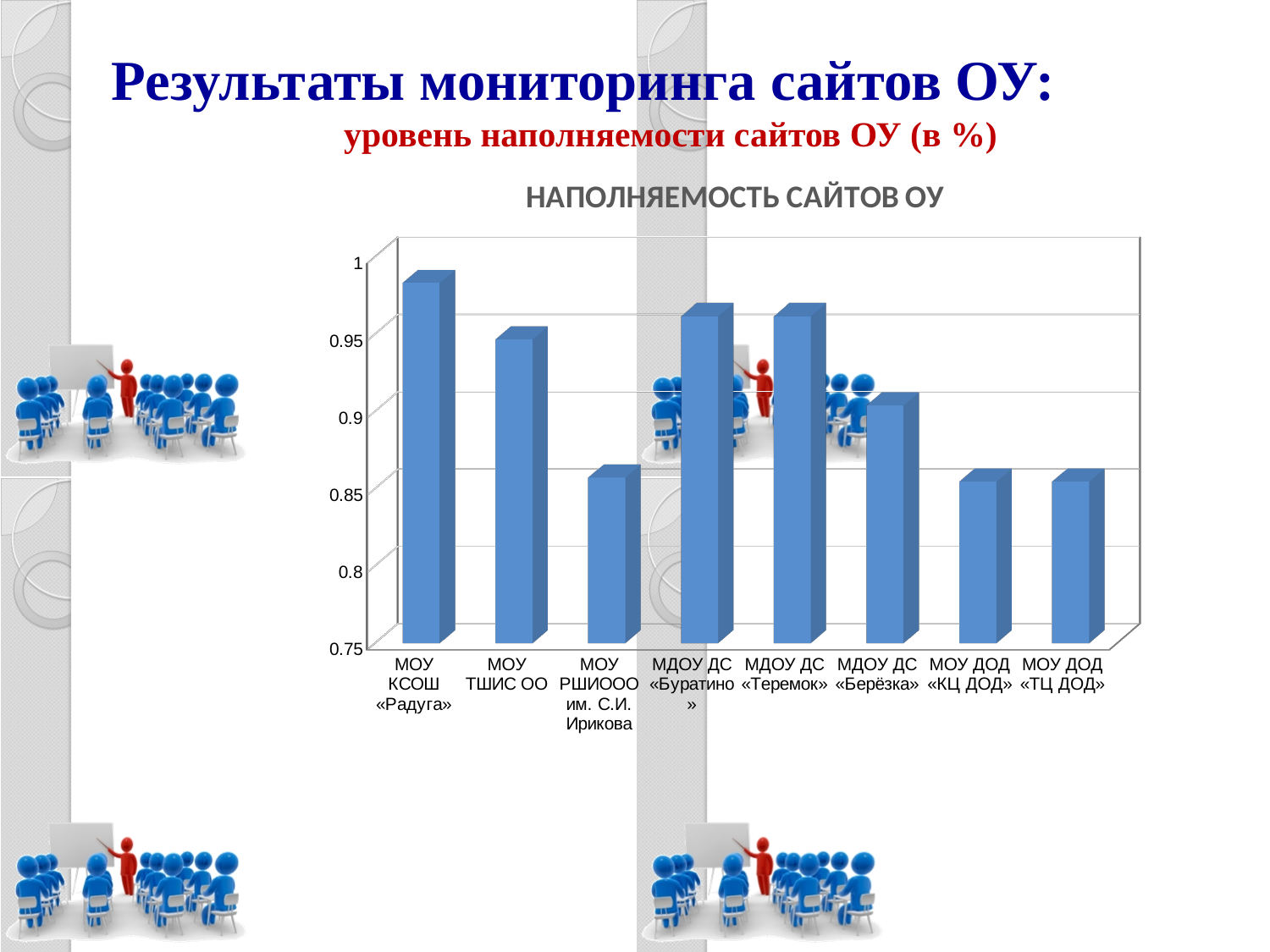
Is the value for МДОУ ДС «Буратино» greater or less than 0.9? greater Which institution has the highest bar in the chart? МОУ КСОШ «Радуга» Is the value for МОУ ДОД «ТЦ ДОД» greater or less than 0.9? less Which has the larger value: МДОУ ДС «Теремок» or МДОУ ДС «Берёзка»? МДОУ ДС «Теремок» Which has the larger value: МОУ КСОШ «Радуга» or МОУ ТШИС ОО? МОУ КСОШ «Радуга» How many categories (institutions) are shown on the x axis of the chart? 8 Is the value for МОУ РШИООО им. С.И. Ирикова greater or less than 0.9? less What is the lowest value shown on the vertical axis of the chart? 0.75 What kind of chart is shown on the slide? bar chart What is the title of the chart? НАПОЛНЯЕМОСТЬ САЙТОВ ОУ